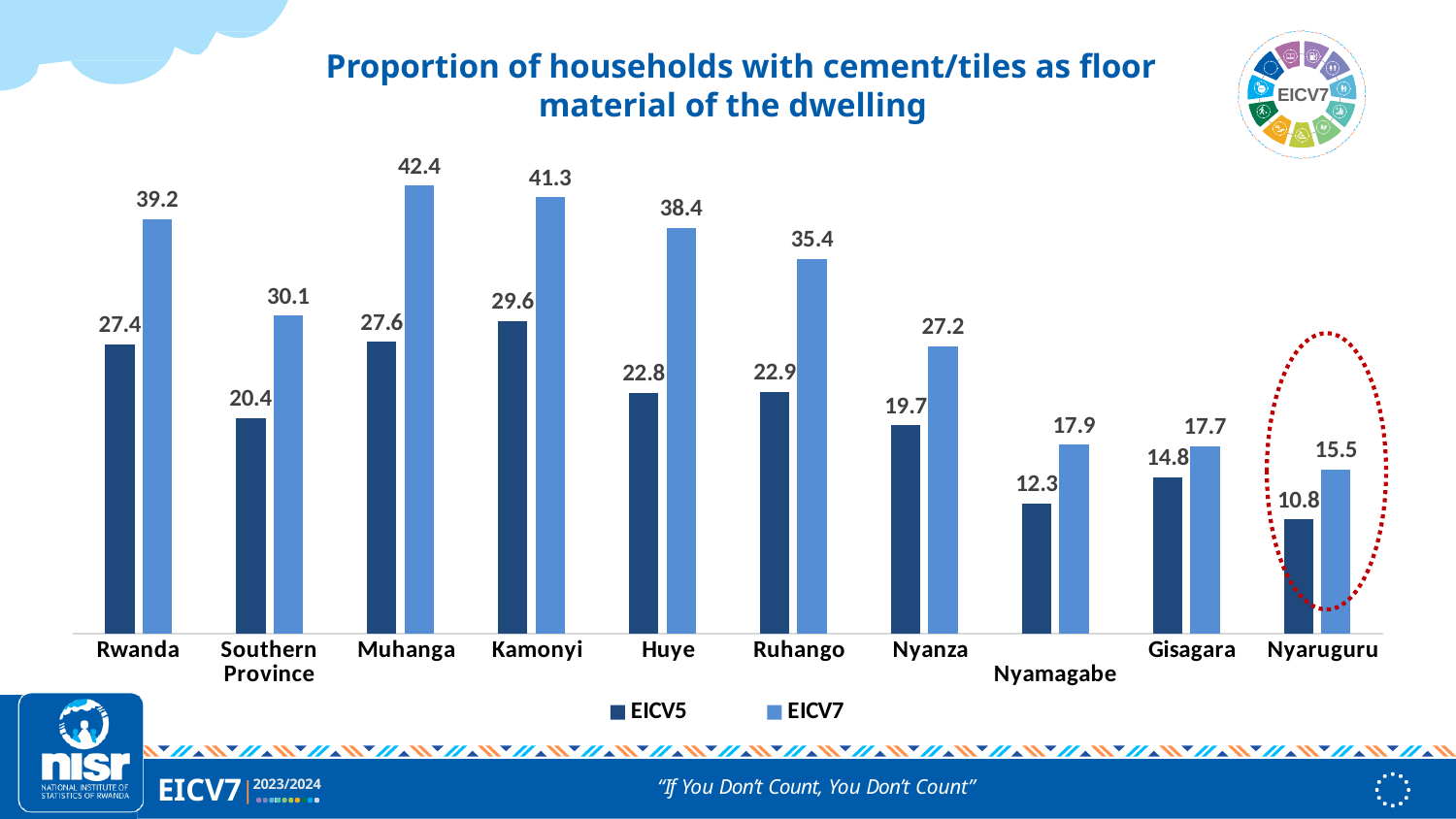
How many series does the legend list? 2 Which category has the lowest EICV5 value? Nyaruguru What is the difference between the EICV7 values for Nyamagabe and Gisagara? 0.2 Which category on the chart is circled with a red dotted outline? Nyaruguru What kind of chart is shown on the slide? Bar chart What is the EICV5 value for Nyaruguru? 10.8 Which is larger, the EICV7 value for Huye or the EICV7 value for Ruhango? Huye Which category has the highest EICV7 value? Muhanga What is the difference between the EICV7 and EICV5 values for Rwanda? 11.8 What is the EICV7 value for Southern Province? 30.1 What is the EICV7 value for Muhanga? 42.4 How many categories are shown on the x axis? 10